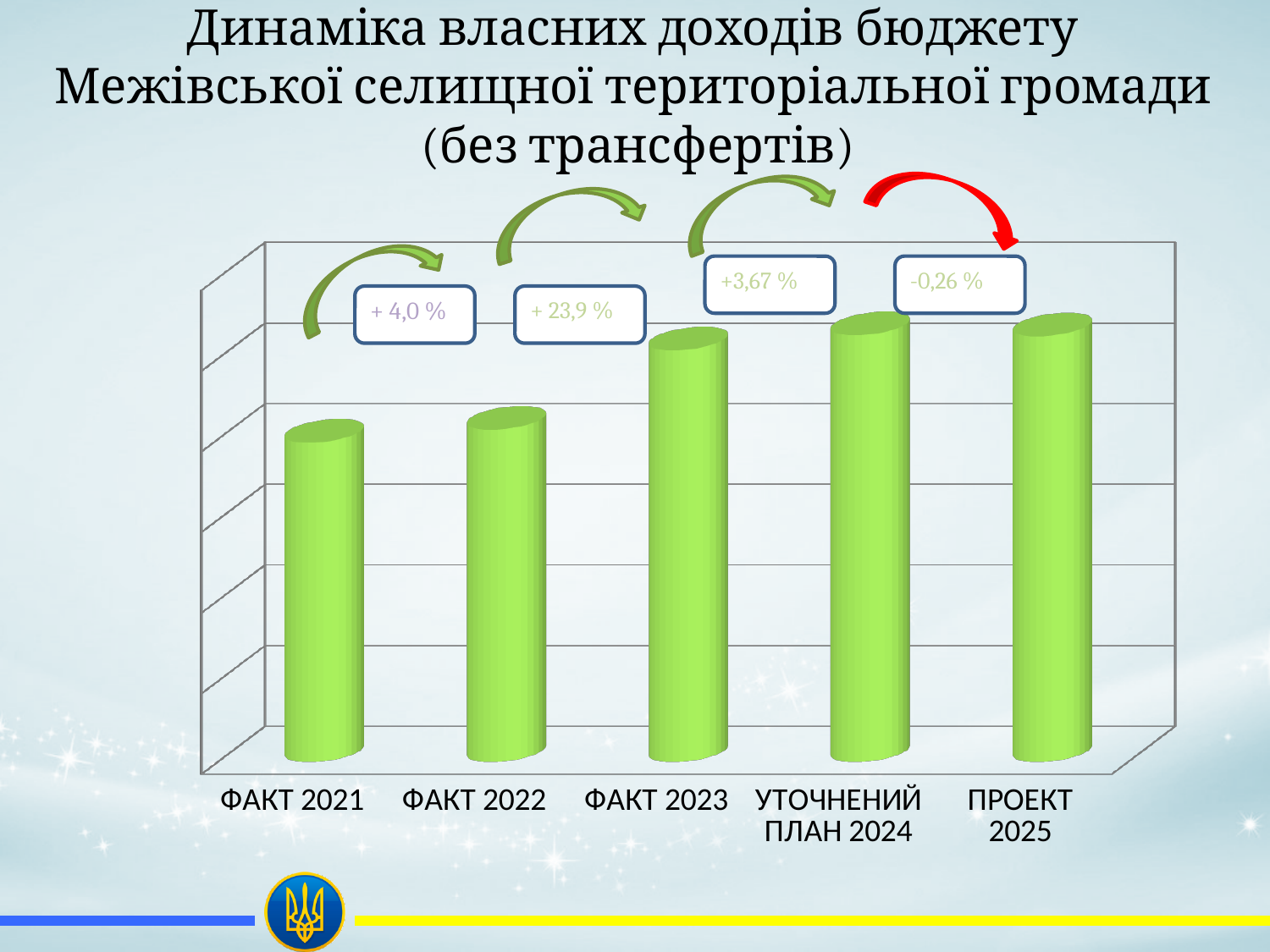
Which category has the lowest bar in the chart? ФАКТ 2021 Which bar is taller: ФАКТ 2021 or УТОЧНЕНИЙ ПЛАН 2024? УТОЧНЕНИЙ ПЛАН 2024 What is the label of the last category on the x axis? ПРОЕКТ 2025 What percentage change is shown between ФАКТ 2021 and ФАКТ 2022? + 4,0 % Which of the percentage-change annotations is the only negative one? -0,26 % Which bar is taller: ФАКТ 2022 or ФАКТ 2023? ФАКТ 2023 What kind of chart is shown on the slide? bar chart Do the bars rise or fall from ФАКТ 2021 to УТОЧНЕНИЙ ПЛАН 2024? rise What percentage change is shown between ФАКТ 2023 and УТОЧНЕНИЙ ПЛАН 2024? +3,67 % What percentage change is shown between ФАКТ 2022 and ФАКТ 2023? + 23,9 % What percentage change is shown between УТОЧНЕНИЙ ПЛАН 2024 and ПРОЕКТ 2025? -0,26 % How many bars (categories) does the chart show? 5